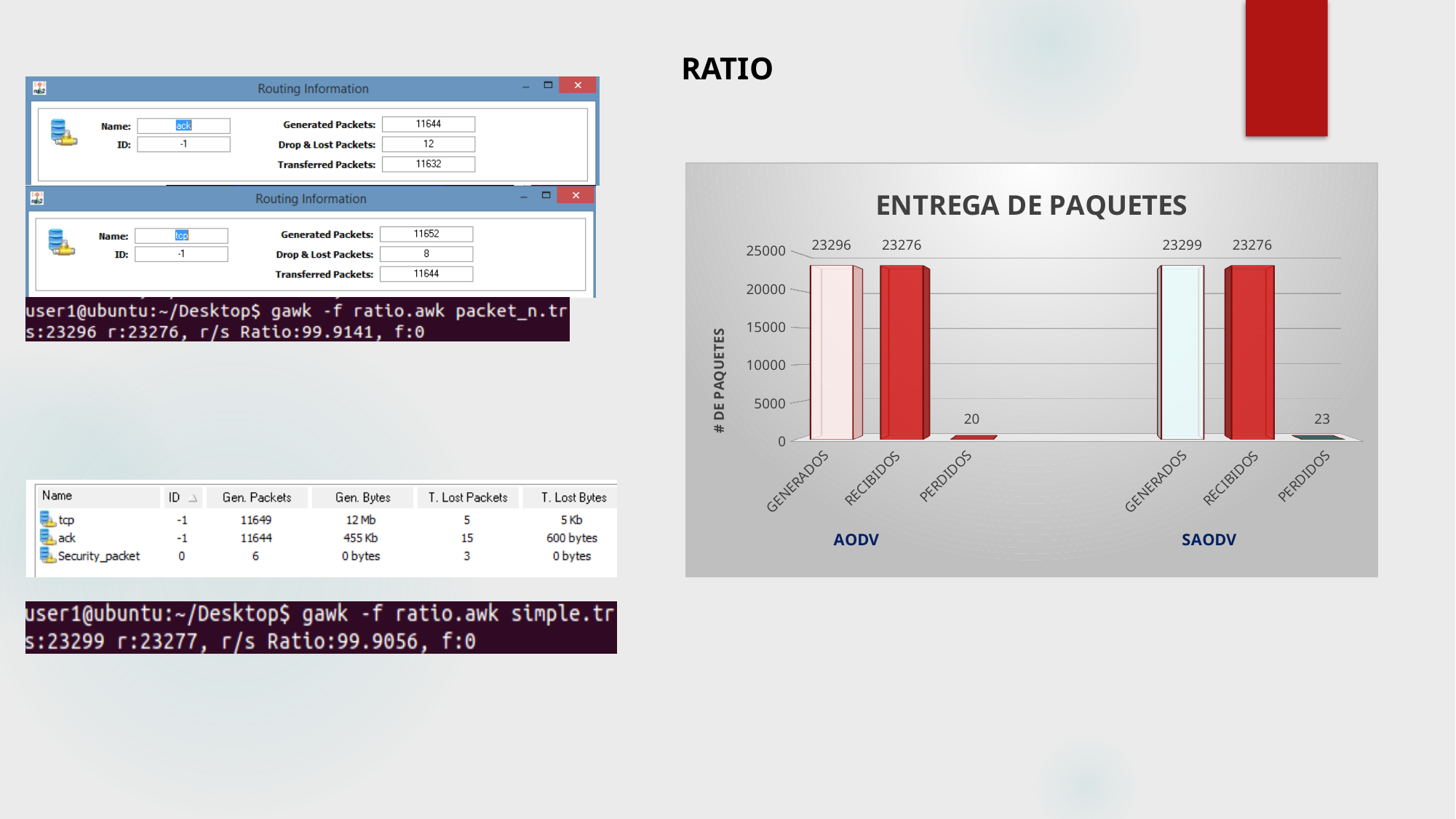
What is the value of GENERADOS for AODV in the ENTREGA DE PAQUETES chart? 23296 Is PERDIDOS for SAODV larger or smaller than PERDIDOS for AODV in the ENTREGA DE PAQUETES chart? larger Which bar has the highest value in the ENTREGA DE PAQUETES chart? GENERADOS for SAODV What is the value of PERDIDOS for AODV in the ENTREGA DE PAQUETES chart? 20 What is the value of RECIBIDOS for SAODV in the ENTREGA DE PAQUETES chart? 23276 How many bars are plotted in the ENTREGA DE PAQUETES chart? 6 Is the value of RECIBIDOS for AODV greater or less than 20000 in the ENTREGA DE PAQUETES chart? greater What is the difference between GENERADOS and RECIBIDOS for AODV in the ENTREGA DE PAQUETES chart? 20 What is the difference between GENERADOS for SAODV and GENERADOS for AODV in the ENTREGA DE PAQUETES chart? 3 Which bar has the lowest value in the ENTREGA DE PAQUETES chart? PERDIDOS for AODV What type of chart is ENTREGA DE PAQUETES? bar chart What is the value of PERDIDOS for SAODV in the ENTREGA DE PAQUETES chart? 23